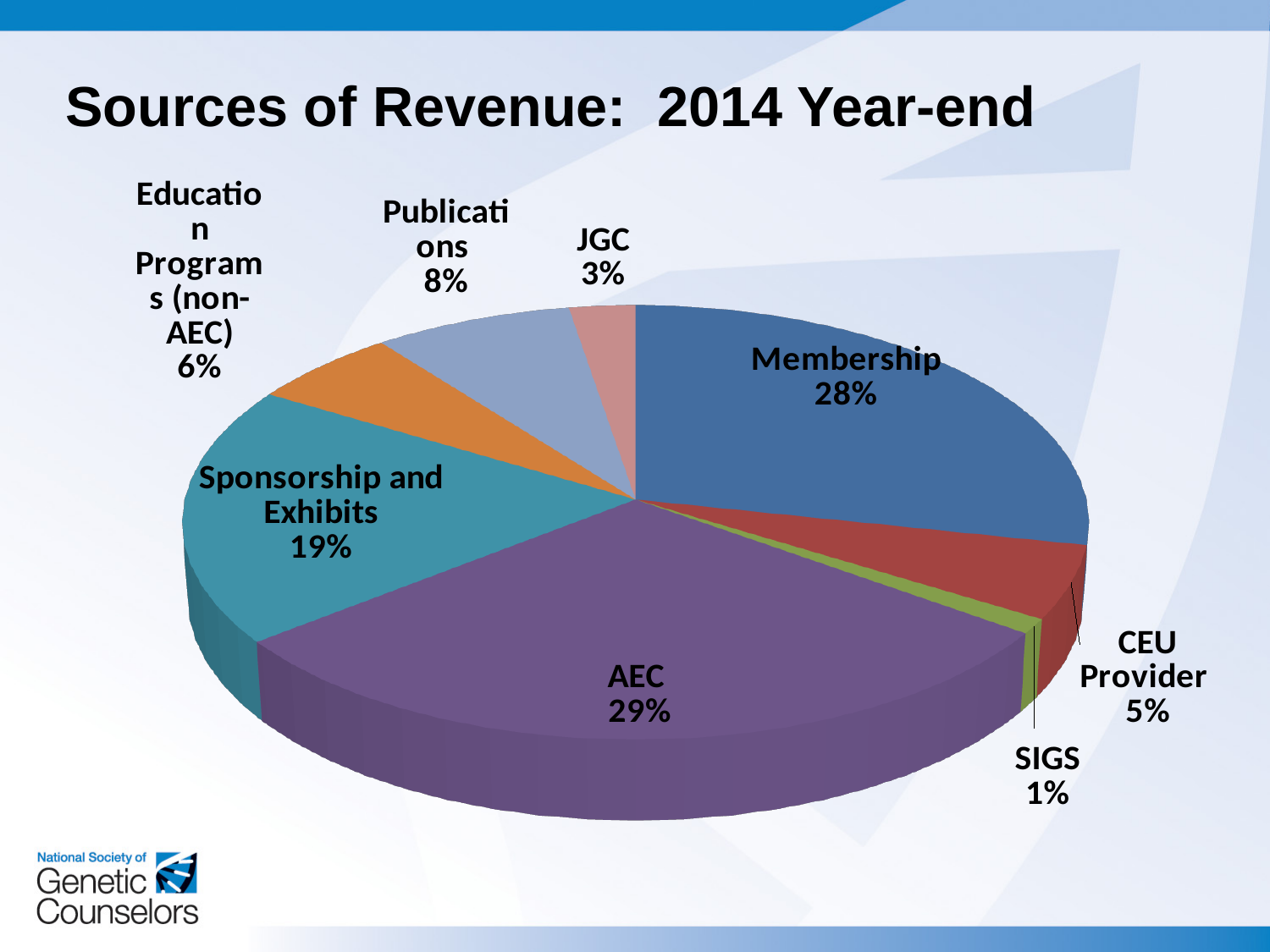
What kind of chart is shown on the slide? Pie chart What share of revenue comes from Publications? 8% What share of revenue comes from CEU Provider? 5% Which revenue source has the largest share? AEC What share of revenue comes from Sponsorship and Exhibits? 19% What is the combined share of Membership and AEC? 57% Which is larger, the share for Publications or the share for JGC? Publications How many revenue sources are shown in the pie chart? 8 Which revenue source has the smallest share? SIGS What is the difference in share between AEC and Sponsorship and Exhibits? 10% What is the title of the chart? Sources of Revenue: 2014 Year-end What share of revenue comes from Membership? 28%